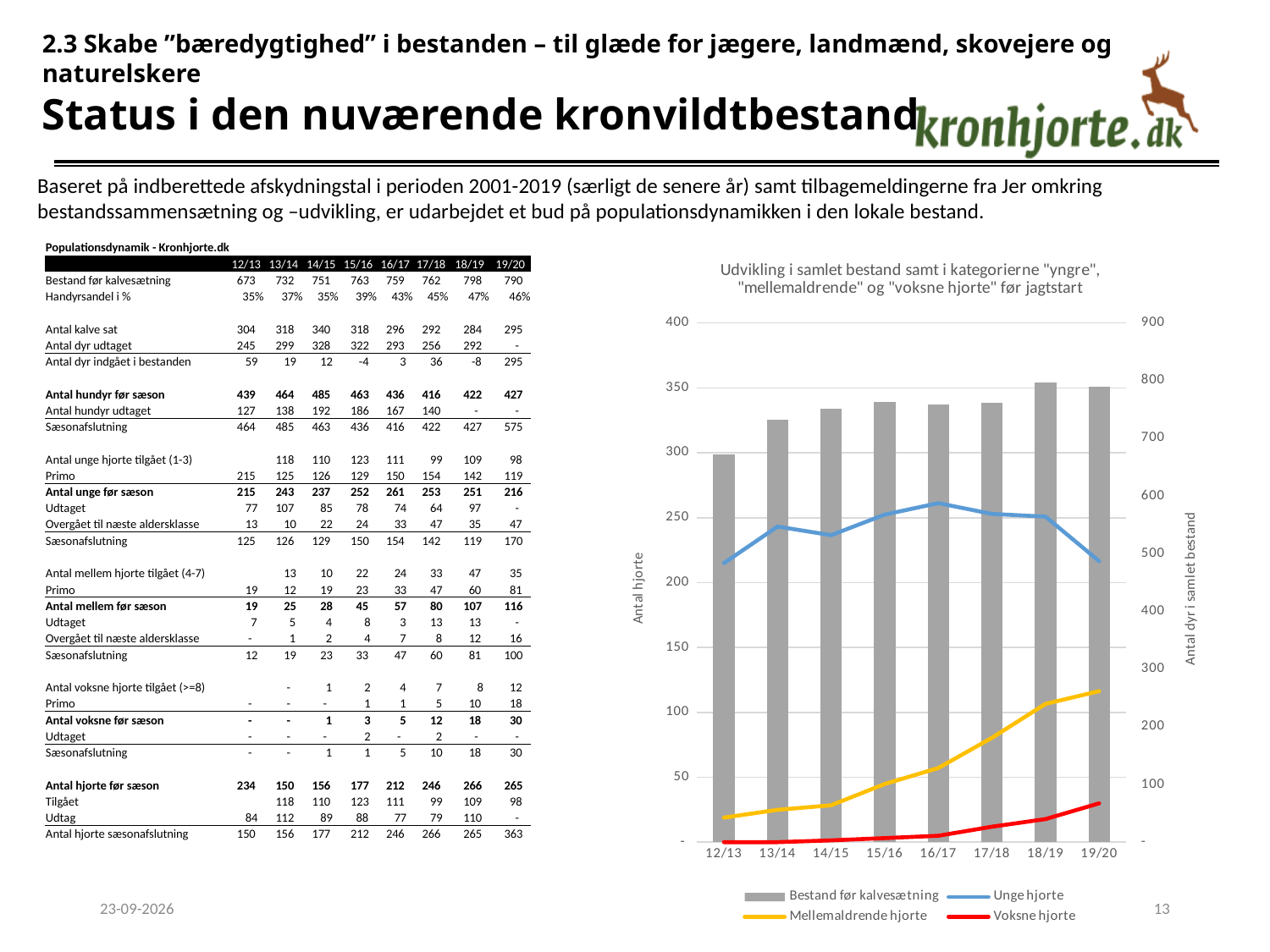
What is the title of the chart? Udvikling i samlet bestand samt i kategorierne "yngre", "mellemaldrende" og "voksne hjorte" før jagtstart In which season does the Mellemaldrende hjorte line reach its highest value? 19/20 Does the Mellemaldrende hjorte line rise or fall from 12/13 to 19/20? rise How many series does the chart legend list? 4 Is the value for Voksne hjorte in 19/20 greater or less than 50? less Is the value for Bestand før kalvesætning in 12/13 greater or less than 700? less Is the value for Mellemaldrende hjorte in 19/20 greater or less than 100? greater How many seasons are shown along the x axis of the chart? 8 In which season is the bar for Bestand før kalvesætning lowest? 12/13 Which series in the chart is drawn as bars? Bestand før kalvesætning In 12/13, which is larger: Unge hjorte or Mellemaldrende hjorte? Unge hjorte What kind of chart is shown on the slide? A combined bar and line chart